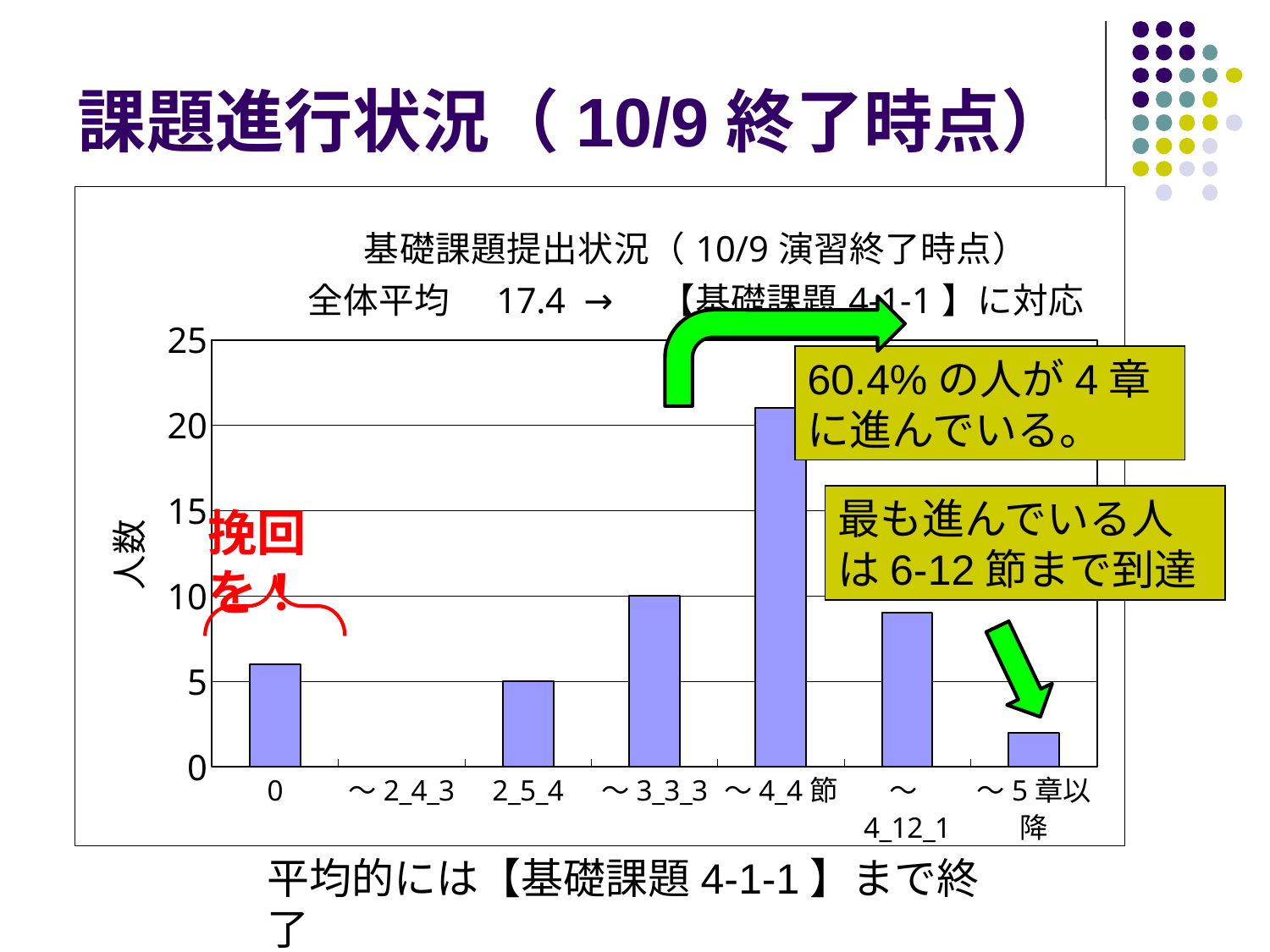
Which category has the tallest bar in the chart? ～4_4節 What is the value for the category ～3_3_3? 10 What is the label on the vertical axis of the chart? 人数 Is the value for the category ～4_12_1 greater or less than 10? less Which is larger, the value for ～4_4節 or the value for ～4_12_1? ～4_4節 What kind of chart is shown on the slide? bar chart What is the value for the category 2_5_4? 5 How many categories are shown on the x axis of the chart? 7 Is the value for the category ～5章以降 greater or less than 5? less What is the title of the chart? 基礎課題提出状況（10/9 演習終了時点） Is the value for the category 0 greater or less than 5? greater